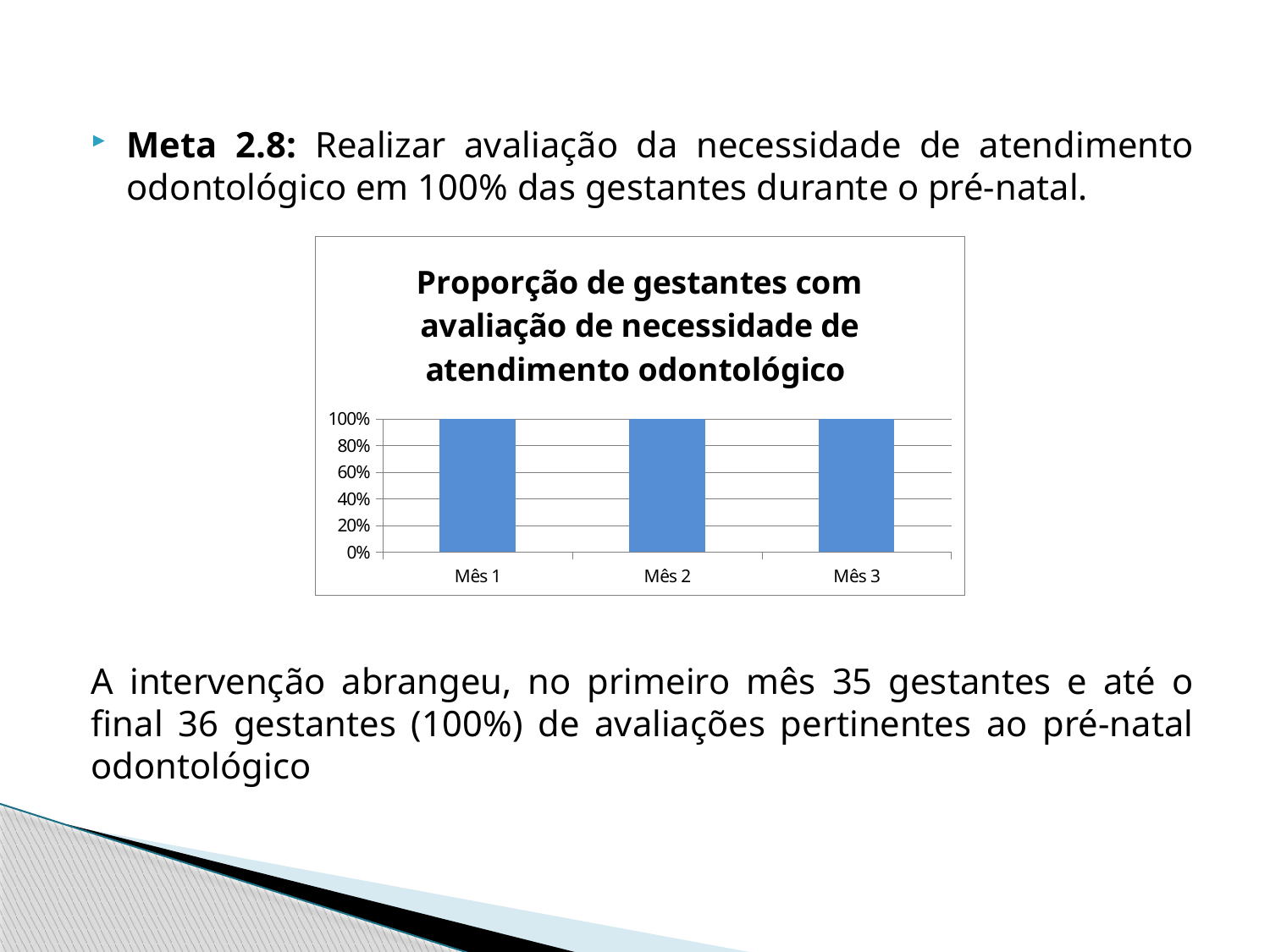
What kind of chart is shown on the slide? bar chart What is the value for Mês 3? 100% What is the highest value shown on the y axis of the chart? 100% Is the value for Mês 2 greater or less than 80%? greater What is the difference between the values for Mês 1 and Mês 3? 0% Do the values rise, fall or stay the same from Mês 1 to Mês 3? stay the same How many categories are shown on the x axis of the chart? 3 What is the title of the chart? Proporção de gestantes com avaliação de necessidade de atendimento odontológico Is the value for Mês 3 greater or less than 60%? greater What is the value for Mês 1? 100% What is the value for Mês 2? 100%